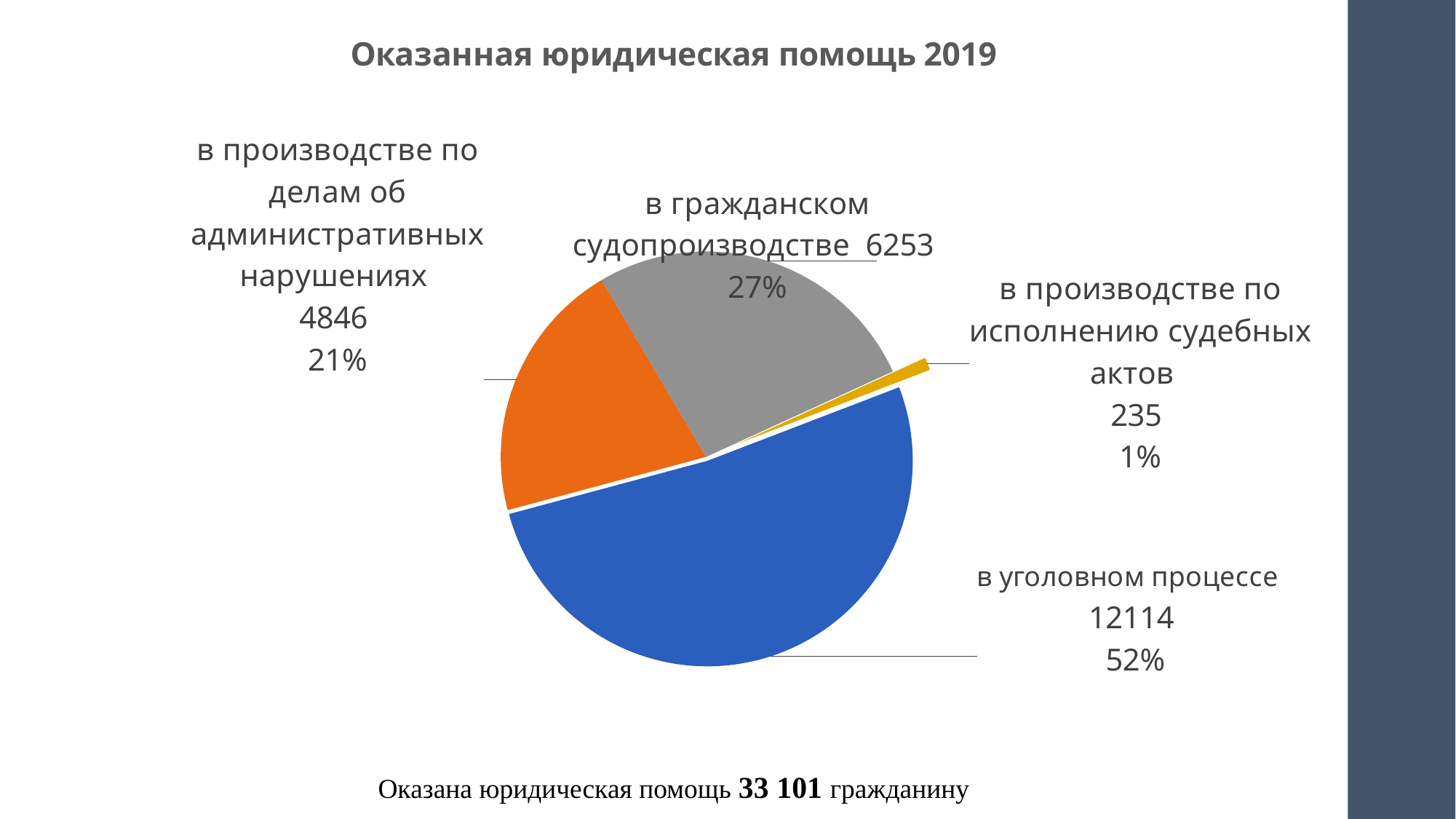
What share of the pie does "в уголовном процессе" represent? 52% What is the value for "в гражданском судопроизводстве"? 6253 What is the title of the chart? Оказанная юридическая помощь 2019 What is the difference between the values for "в уголовном процессе" and "в гражданском судопроизводстве"? 5861 Which category has the largest slice? в уголовном процессе What is the value for "в уголовном процессе"? 12114 How many slices does the pie chart have? 4 What share of the pie does "в производстве по делам об административных нарушениях" represent? 21% What kind of chart is shown on the slide? pie chart Which is larger: the value for "в гражданском судопроизводстве" or for "в производстве по делам об административных нарушениях"? в гражданском судопроизводстве Which category has the smallest slice? в производстве по исполнению судебных актов What is the value for "в производстве по исполнению судебных актов"? 235